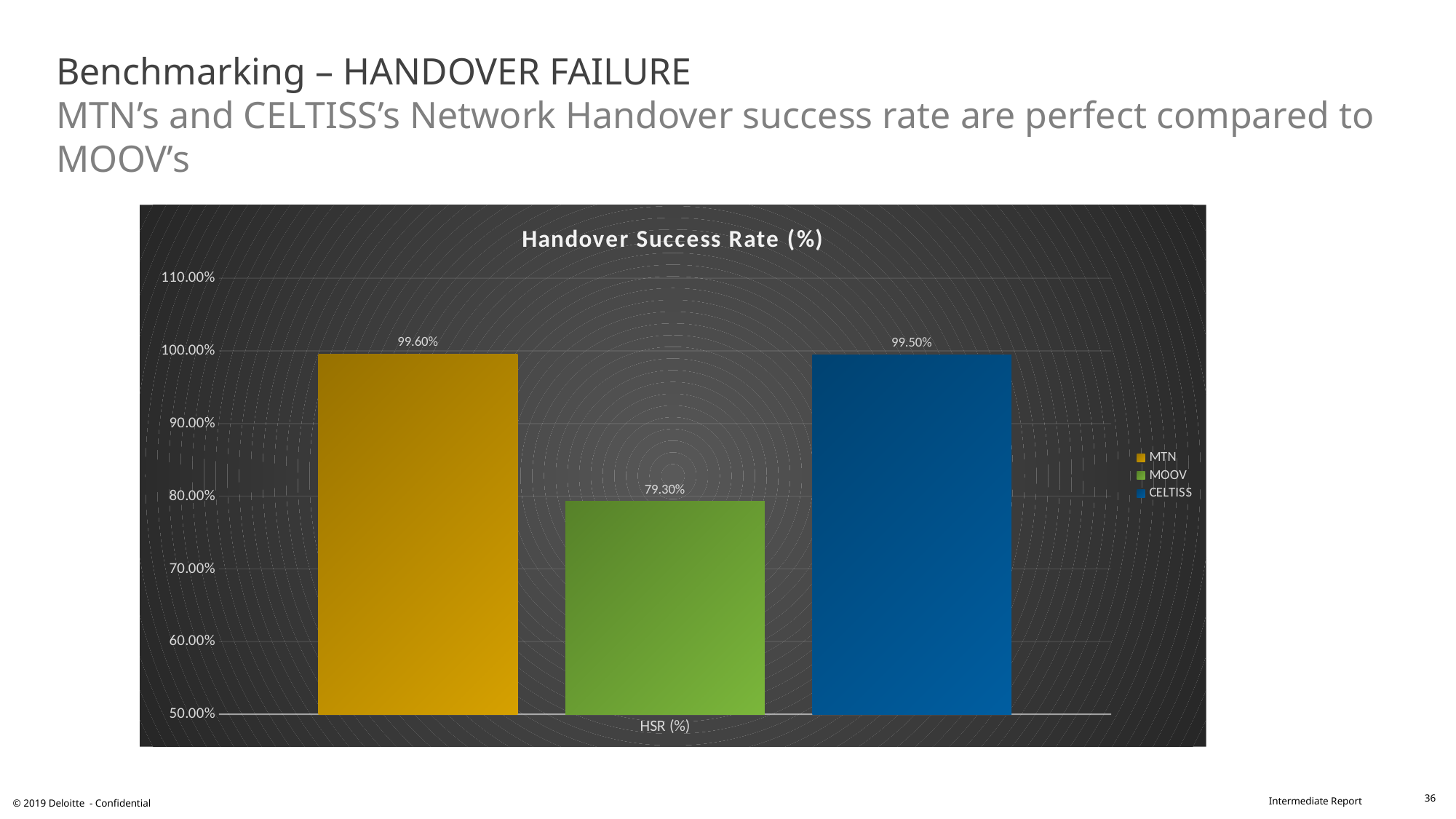
What is the difference between MTN's and MOOV's Handover Success Rate? 20.30% Which operator has the lowest Handover Success Rate? MOOV What kind of chart is shown on the slide? bar chart How many series does the legend list? 3 What is the difference between MTN's and CELTISS's Handover Success Rate? 0.10% What colour is the bar for CELTISS? blue Which is larger, the Handover Success Rate for MTN or for MOOV? MTN What is the Handover Success Rate for MOOV? 79.30% What is the title of the chart? Handover Success Rate (%) What is the Handover Success Rate for MTN? 99.60% What is the Handover Success Rate for CELTISS? 99.50% Is the value for MOOV greater or less than 80.00%? less